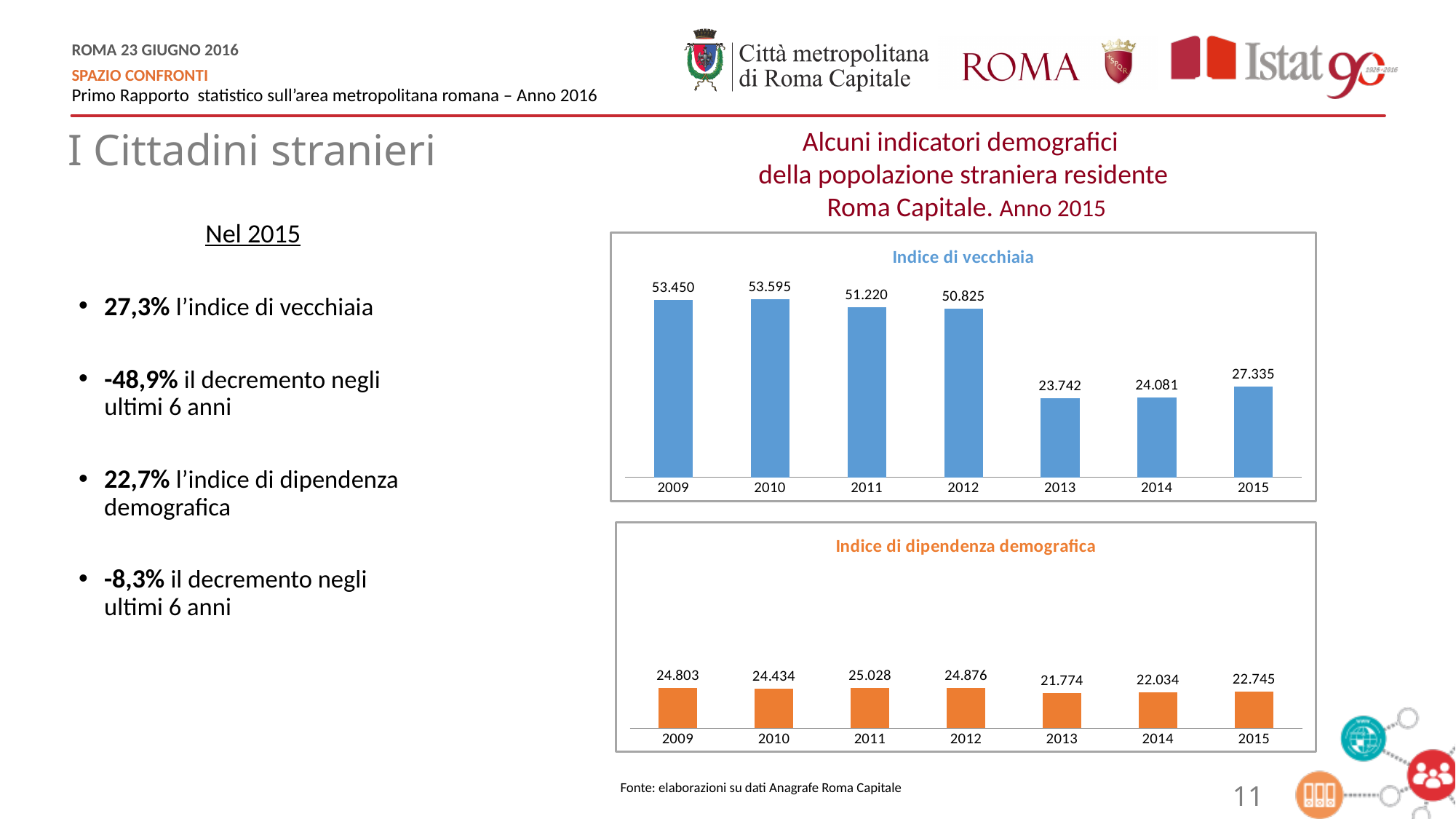
What kind of chart is the 'Indice di vecchiaia' chart? Bar chart How many years are shown in the 'Indice di dipendenza demografica' chart? 7 In the 'Indice di dipendenza demografica' chart, what is the difference between the values for 2011 and 2013? 3.254 In the 'Indice di vecchiaia' chart, what is the difference between the values for 2010 and 2015? 26.260 In the 'Indice di dipendenza demografica' chart, what is the value for 2013? 21.774 In the 'Indice di vecchiaia' chart, which year has the lowest value? 2013 In the 'Indice di vecchiaia' chart, which year has the larger value, 2013 or 2014? 2014 In the 'Indice di dipendenza demografica' chart, which year has the lowest value? 2013 In the 'Indice di vecchiaia' chart, do the values overall rise or fall from 2009 to 2015? Fall In the 'Indice di vecchiaia' chart, which year has the highest value? 2010 In the 'Indice di vecchiaia' chart, what is the value for 2015? 27.335 In the 'Indice di dipendenza demografica' chart, which year has the highest value? 2011